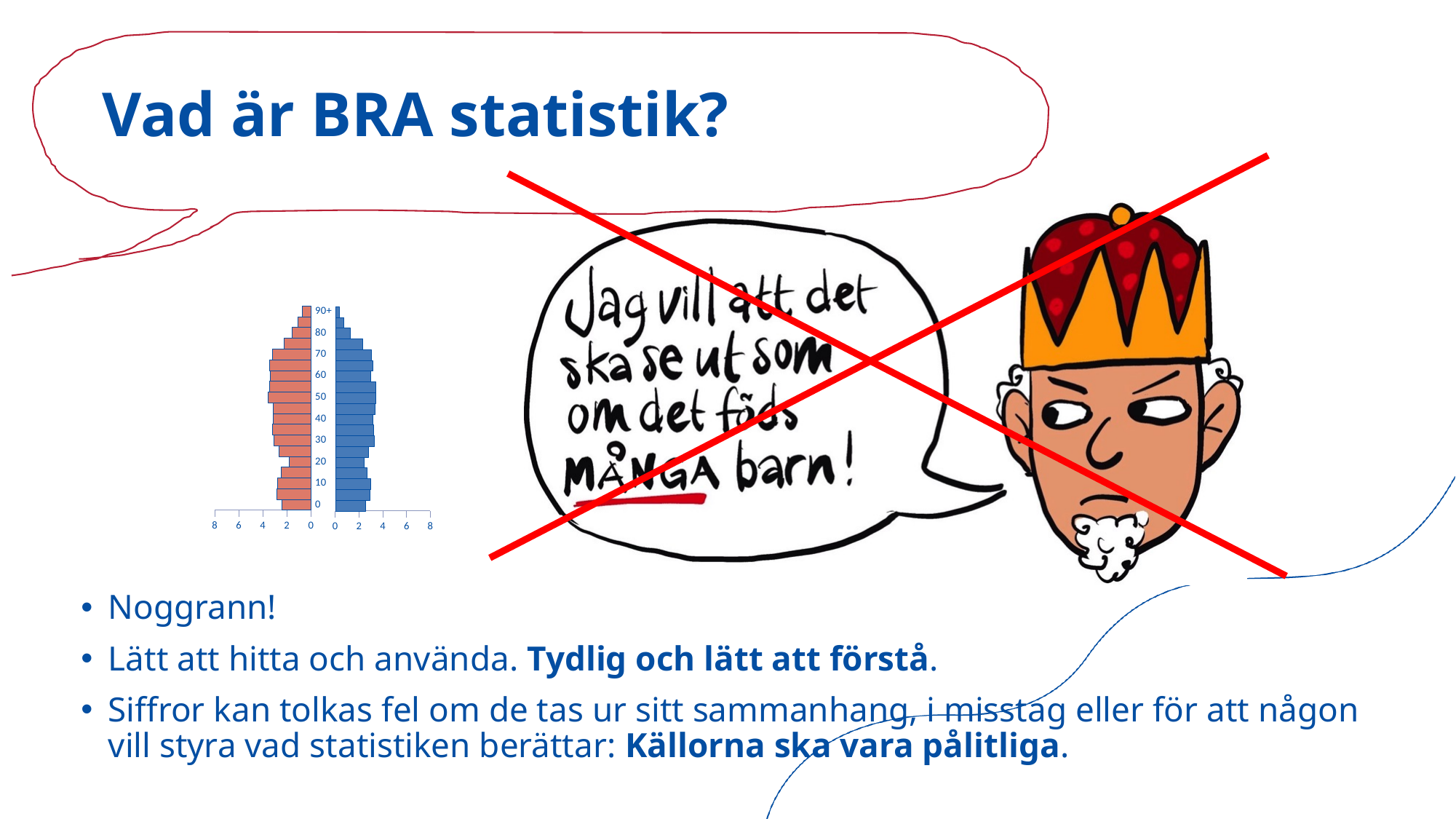
What kind of chart is shown on the left of the slide? bar chart How many age-group labels are shown on the vertical axis of the chart? 10 Is the value of the red bar at age 90+ greater or less than 2? less What is the topmost age-group label on the chart's vertical axis? 90+ Is the value of the blue bar at age 90+ greater or less than 2? less Is the value of the blue bar at age 50 greater or less than 6? less Which side of the chart has the blue bars, left or right? right What is the highest value shown on the horizontal axis of the chart? 8 Do the blue bars get longer or shorter going from age 50 up to age 90+? shorter